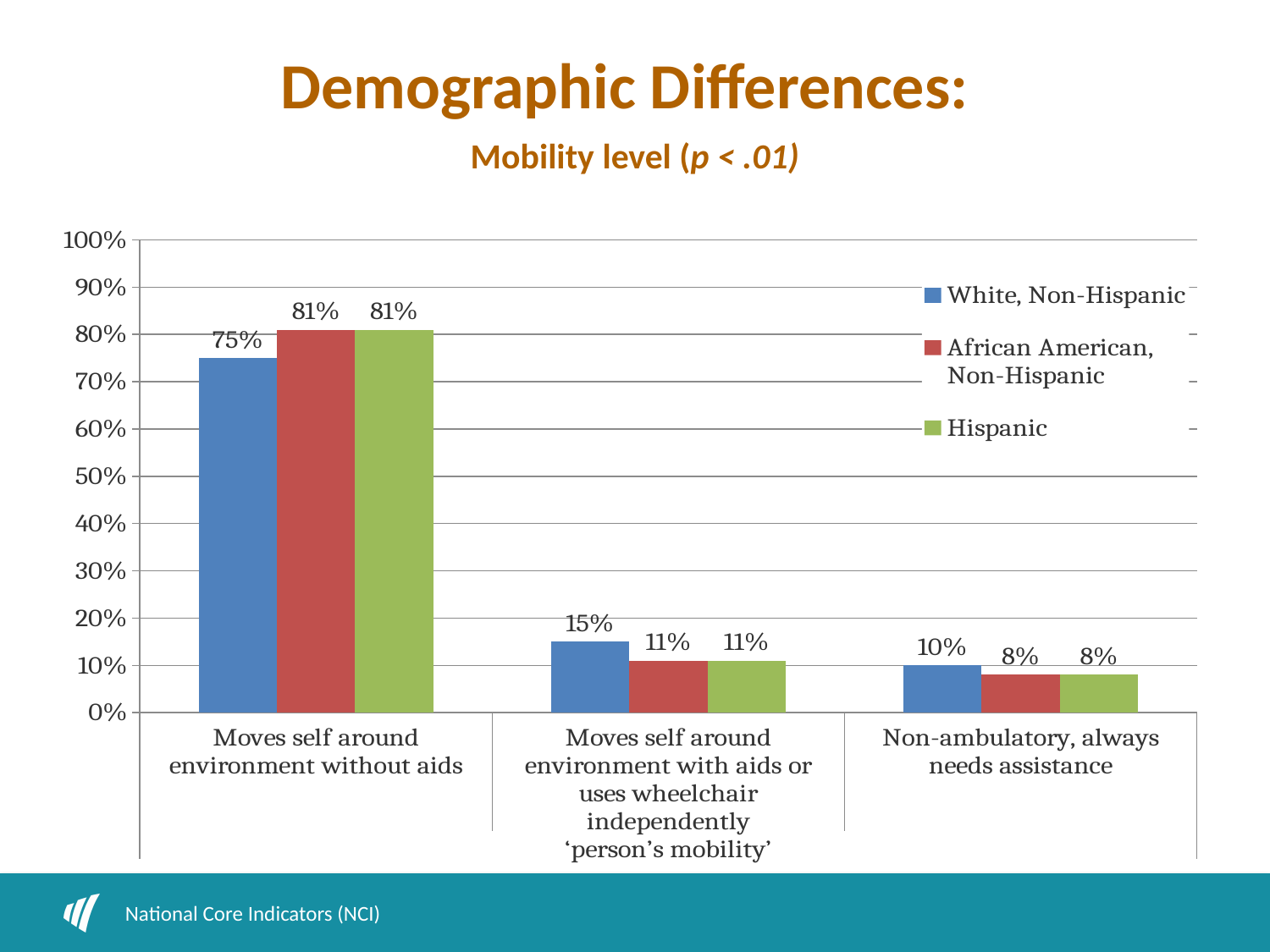
How many mobility level categories are shown on the x axis? 3 What is the difference between the African American, Non-Hispanic and White, Non-Hispanic values for 'Moves self around environment without aids'? 6% Which mobility level category has the highest values across all groups? Moves self around environment without aids What is the value for African American, Non-Hispanic in the 'Moves self around environment with aids or uses wheelchair independently' category? 11% What kind of chart is shown on the slide? Bar chart How many series does the legend list? 3 In the 'Non-ambulatory, always needs assistance' category, which is larger: the White, Non-Hispanic value or the Hispanic value? White, Non-Hispanic Which colour represents the Hispanic series? Green Which group has the lowest value in the 'Moves self around environment without aids' category? White, Non-Hispanic Is the White, Non-Hispanic value for 'Moves self around environment with aids or uses wheelchair independently' greater or less than 20%? less What is the value for Hispanic in the 'Non-ambulatory, always needs assistance' category? 8% What percentage of White, Non-Hispanic individuals move self around environment without aids? 75%